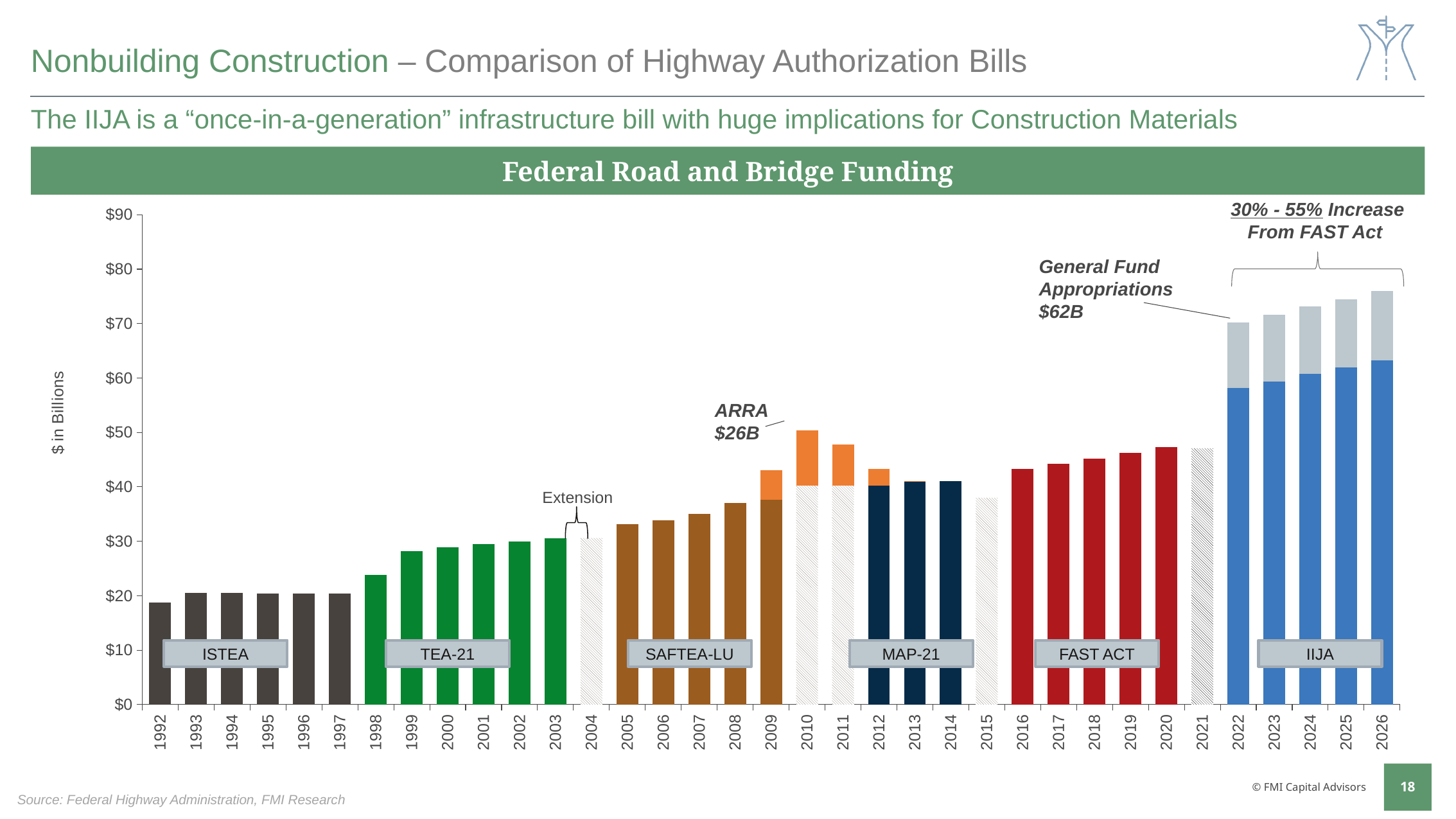
Which year has the lowest bar in the Federal Road and Bridge Funding chart? 1992 Which year has the highest bar in the Federal Road and Bridge Funding chart? 2026 What is the label on the y axis of the Federal Road and Bridge Funding chart? $ in Billions Which year has the larger bar, 2014 or 2020? 2020 How many years are plotted along the x axis of the Federal Road and Bridge Funding chart? 35 Do the bars for the IIJA years (2022 to 2026) rise or fall from left to right? Rise Is the value for 2022 greater or less than $60? greater Is the value for 2005 greater or less than $30? greater Is the value for 2015 greater or less than $40? less What kind of chart is shown under the heading "Federal Road and Bridge Funding"? Bar chart How many highway authorization bills are labelled on the chart (ISTEA, TEA-21, etc.)? 6